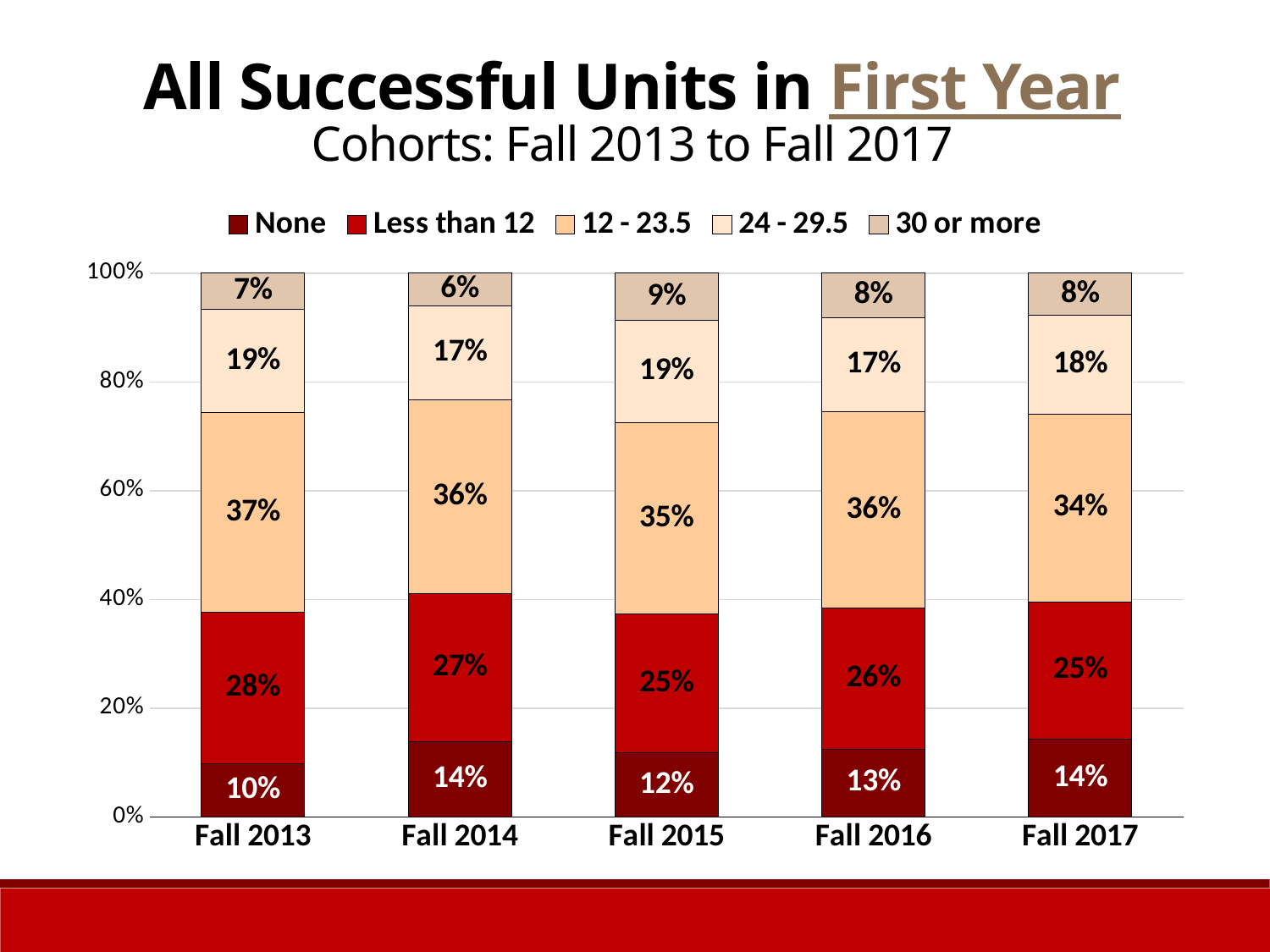
What percentage of the Fall 2017 cohort falls in the '12 - 23.5' category? 34% Which category is the largest segment in the Fall 2014 bar? 12 - 23.5 Which cohort has the highest '30 or more' percentage? Fall 2015 What is the value of the '30 or more' segment for the Fall 2015 cohort? 9% Which cohort has the lowest 'None' percentage? Fall 2013 What type of chart is shown on the slide? Stacked bar chart Which cohort has a larger '12 - 23.5' share, Fall 2013 or Fall 2015? Fall 2013 What is the 'Less than 12' value for the Fall 2016 cohort? 26% How many cohorts are shown on the x axis? 5 What percentage of the Fall 2013 cohort earned no successful units (None) in the first year? 10% How many series does the legend list? 5 What is the difference in percentage points between the 'Less than 12' values for Fall 2013 and Fall 2017? 3 percentage points